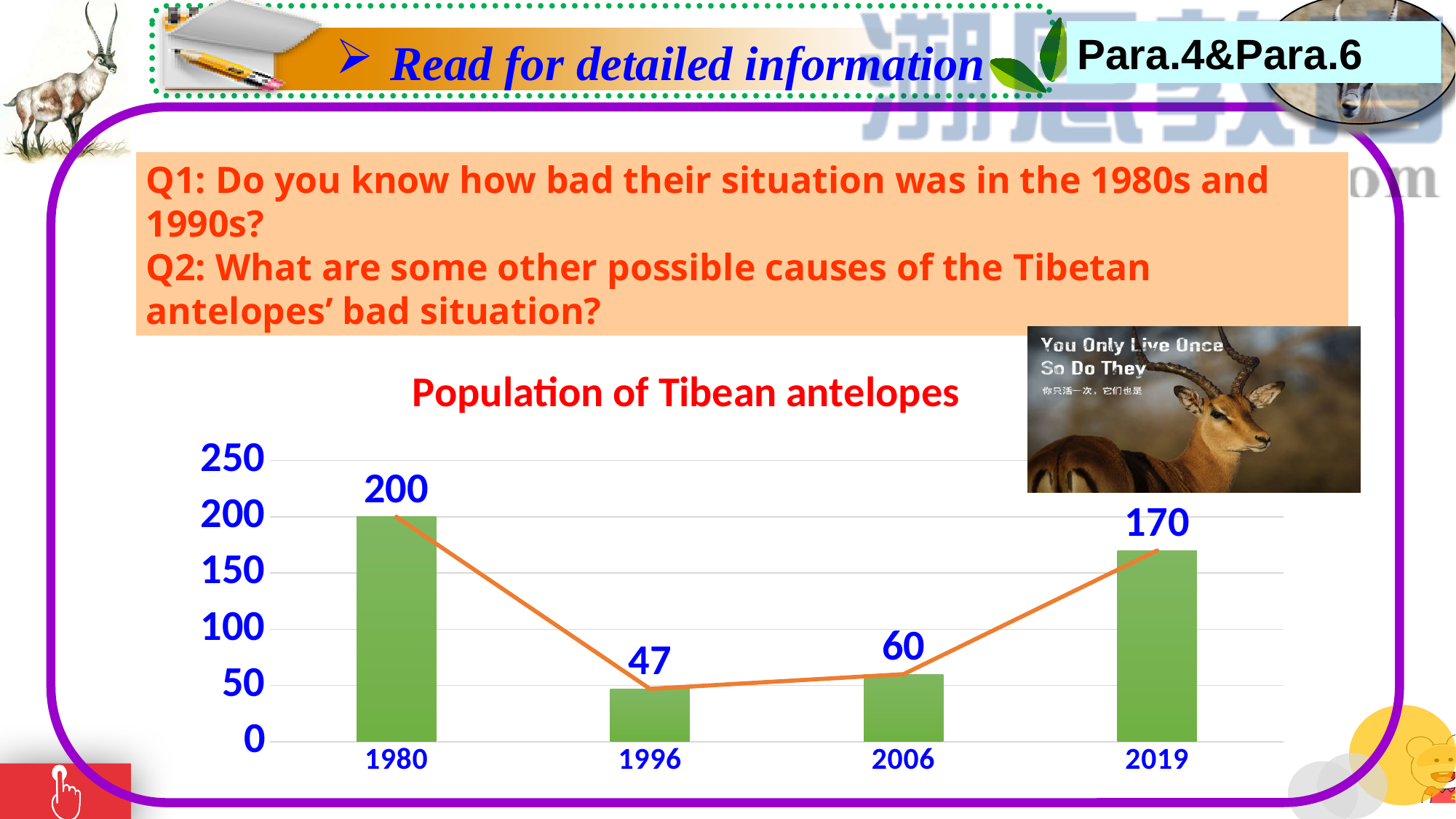
Does the population rise or fall from 2006 to 2019? rise What is the population value shown for 2006? 60 What is the population value shown for 1996? 47 How many years are shown on the x axis of the chart? 4 Which is larger, the value for 2006 or the value for 1996? 2006 Which year has the lowest population value? 1996 What is the title of the chart? Population of Tibean antelopes What is the difference between the values for 1980 and 1996? 153 Which year has the highest population value? 1980 What is the population value shown for 2019? 170 What is the population value shown for 1980? 200 What is the difference between the values for 2019 and 2006? 110